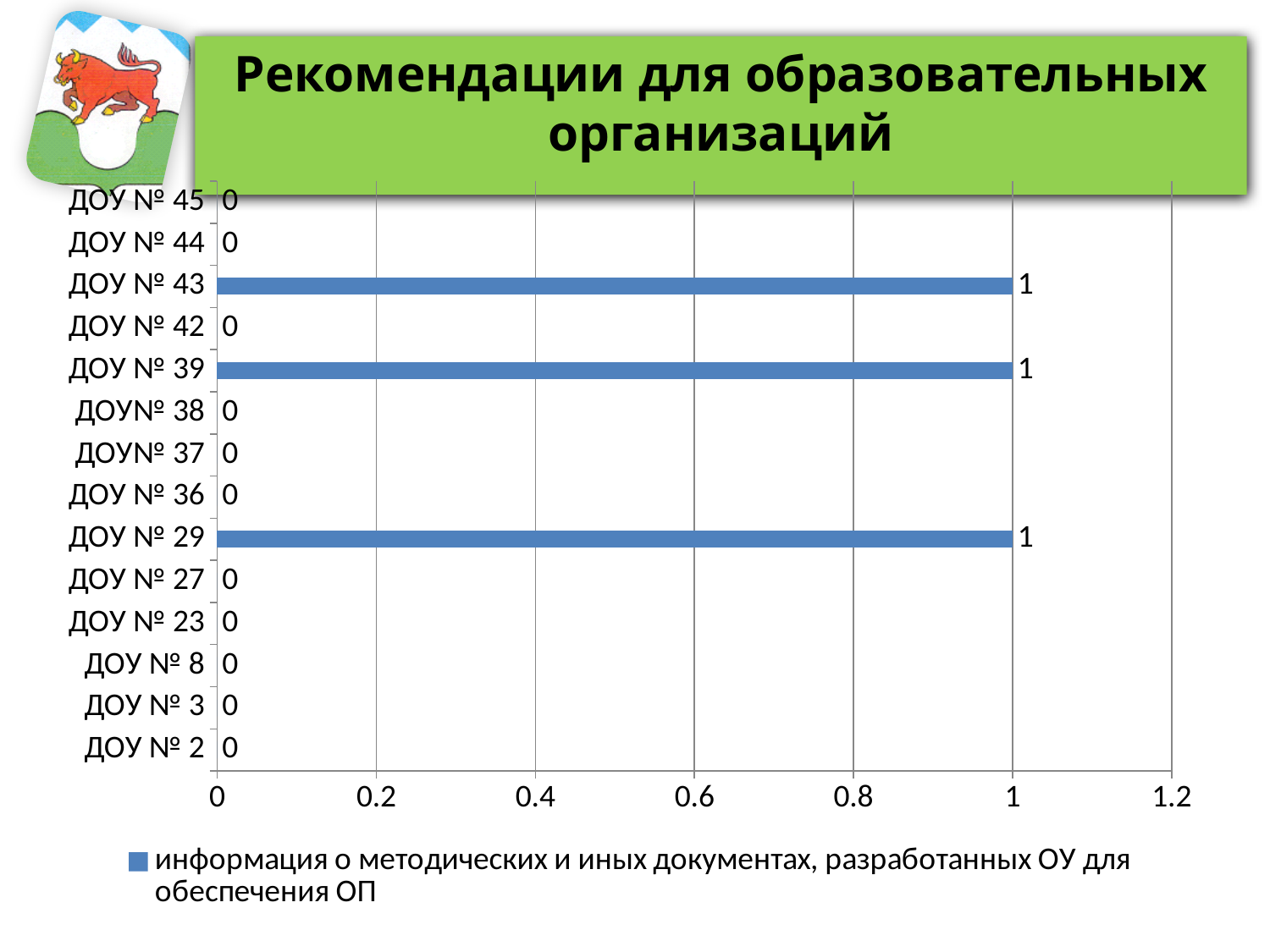
How many categories have a value of 1? 3 How many categories (ДОУ) are listed on the chart? 14 What is the value for ДОУ № 39? 1 What kind of chart is shown on the slide? bar chart What is the difference between the value for ДОУ № 29 and the value for ДОУ № 27? 1 What is the value for ДОУ № 45? 0 What is the value for ДОУ № 43? 1 What is the value for ДОУ № 29? 1 Which is larger, the value for ДОУ № 43 or the value for ДОУ № 42? ДОУ № 43 How many series does the legend list? 1 What is the value for ДОУ № 2? 0 What is the legend entry for the series shown on the chart? информация о методических и иных документах, разработанных ОУ для обеспечения ОП